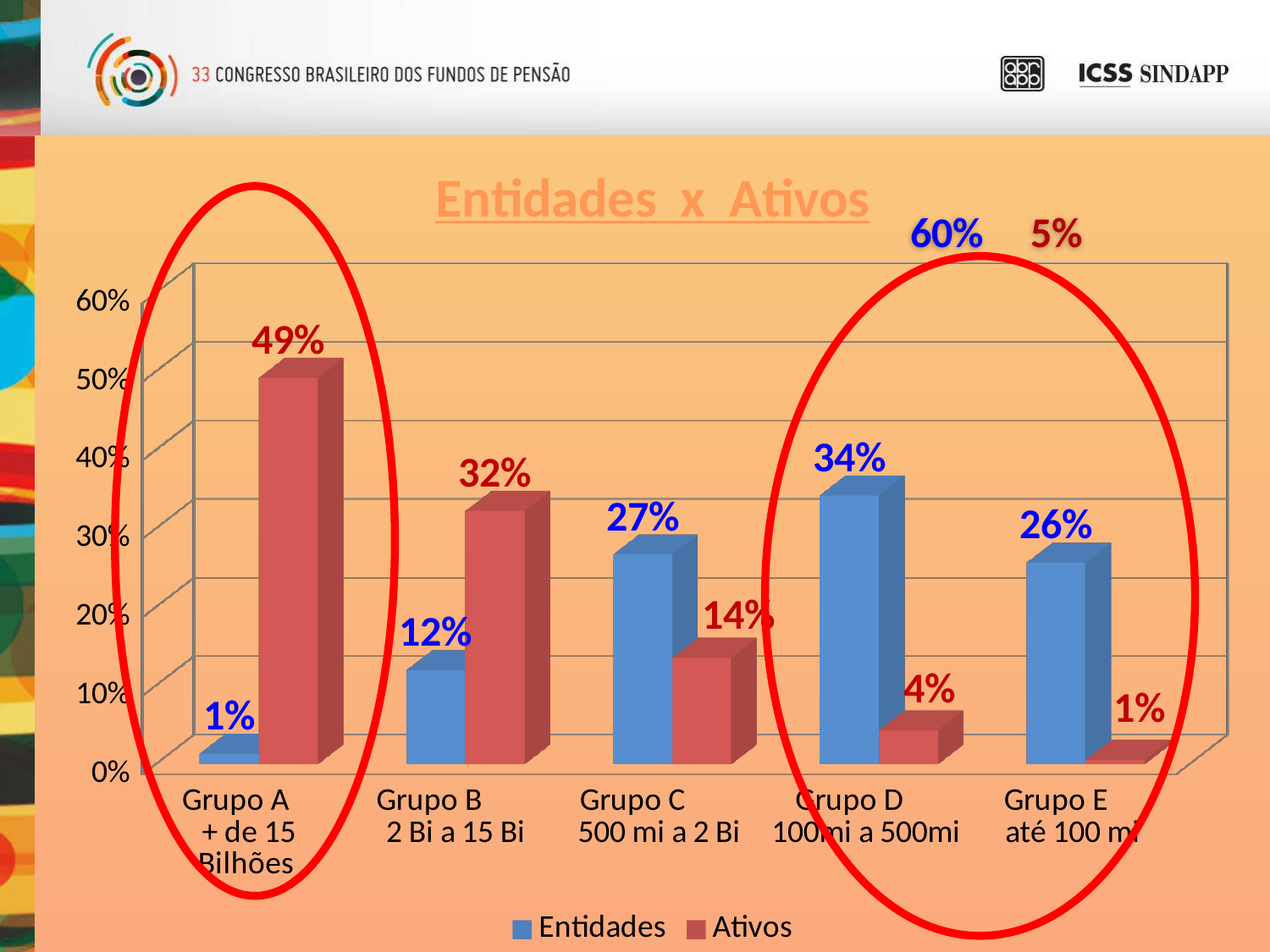
What is the Entidades value for Grupo C? 27% What is the Entidades value for Grupo E? 26% Which is larger for Grupo D, the Entidades value or the Ativos value? Entidades What is the difference between the Ativos and Entidades values for Grupo B? 20% Which group has the highest Ativos value? Grupo A Do the Ativos values rise or fall from Grupo A to Grupo E? Fall What kind of chart is shown on the slide? Bar chart Which group has the lowest Entidades value? Grupo A What is the Ativos value for Grupo A? 49% How many groups are shown on the x axis? 5 How many series does the legend list? 2 What is the title of the chart? Entidades x Ativos